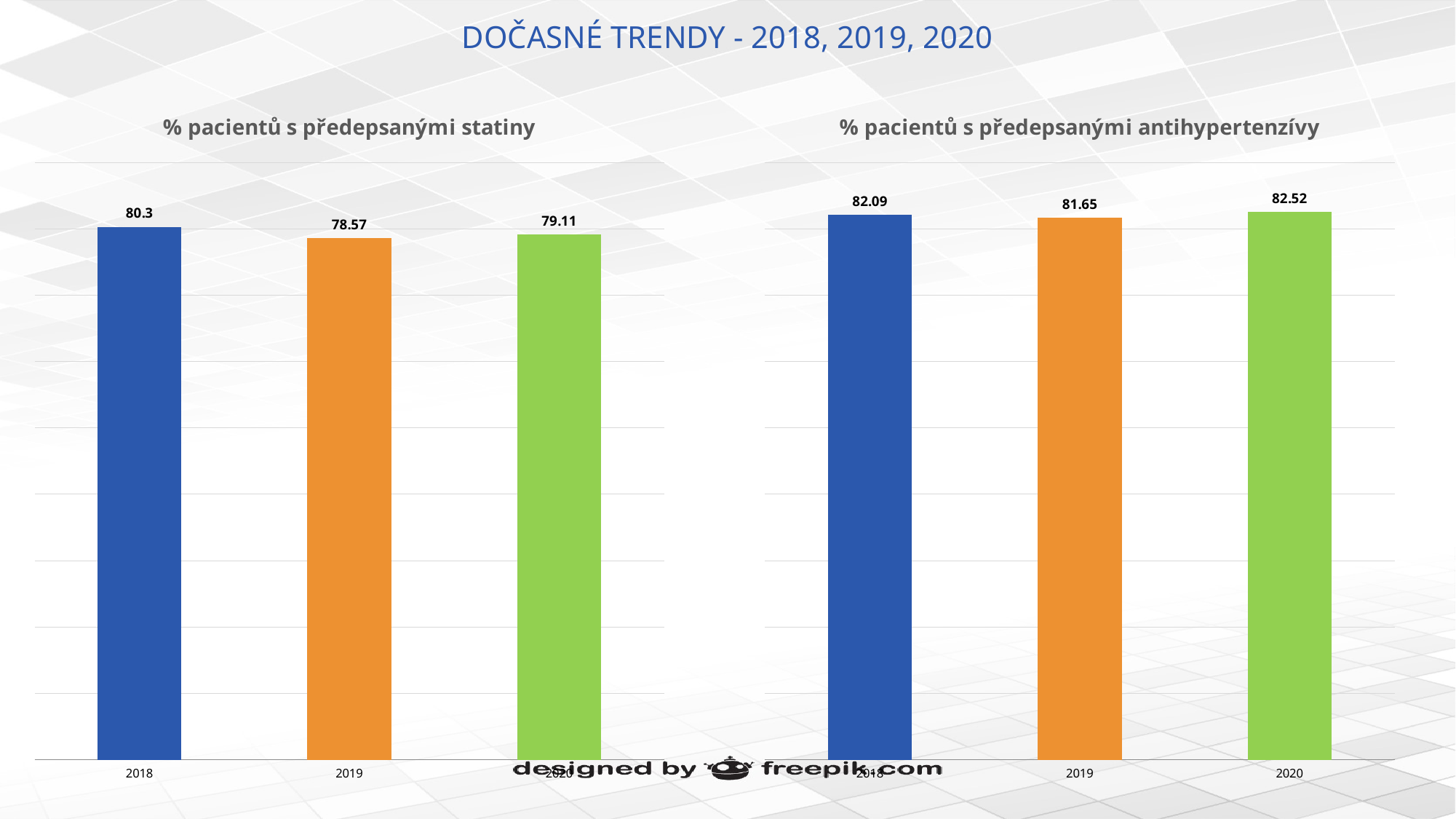
In the chart titled "% pacientů s předepsanými statiny", which is larger, the value for 2019 or the value for 2020? 2020 In the chart titled "% pacientů s předepsanými antihypertenzívy", which year has the lowest value? 2019 In the chart titled "% pacientů s předepsanými statiny", what is the value for 2019? 78.57 In the chart titled "% pacientů s předepsanými antihypertenzívy", what is the value for 2020? 82.52 In the chart titled "% pacientů s předepsanými antihypertenzívy", what is the value for 2019? 81.65 In the chart titled "% pacientů s předepsanými antihypertenzívy", what is the difference between the 2020 and 2019 values? 0.87 In the chart titled "% pacientů s předepsanými statiny", what is the value for 2018? 80.3 What type of chart is the chart on the left of the slide? Bar chart How many bars are shown in the chart titled "% pacientů s předepsanými antihypertenzívy"? 3 What is the title of the chart on the right of the slide? % pacientů s předepsanými antihypertenzívy In the chart titled "% pacientů s předepsanými statiny", which year has the highest value? 2018 In the chart titled "% pacientů s předepsanými statiny", what is the difference between the 2018 and 2019 values? 1.73